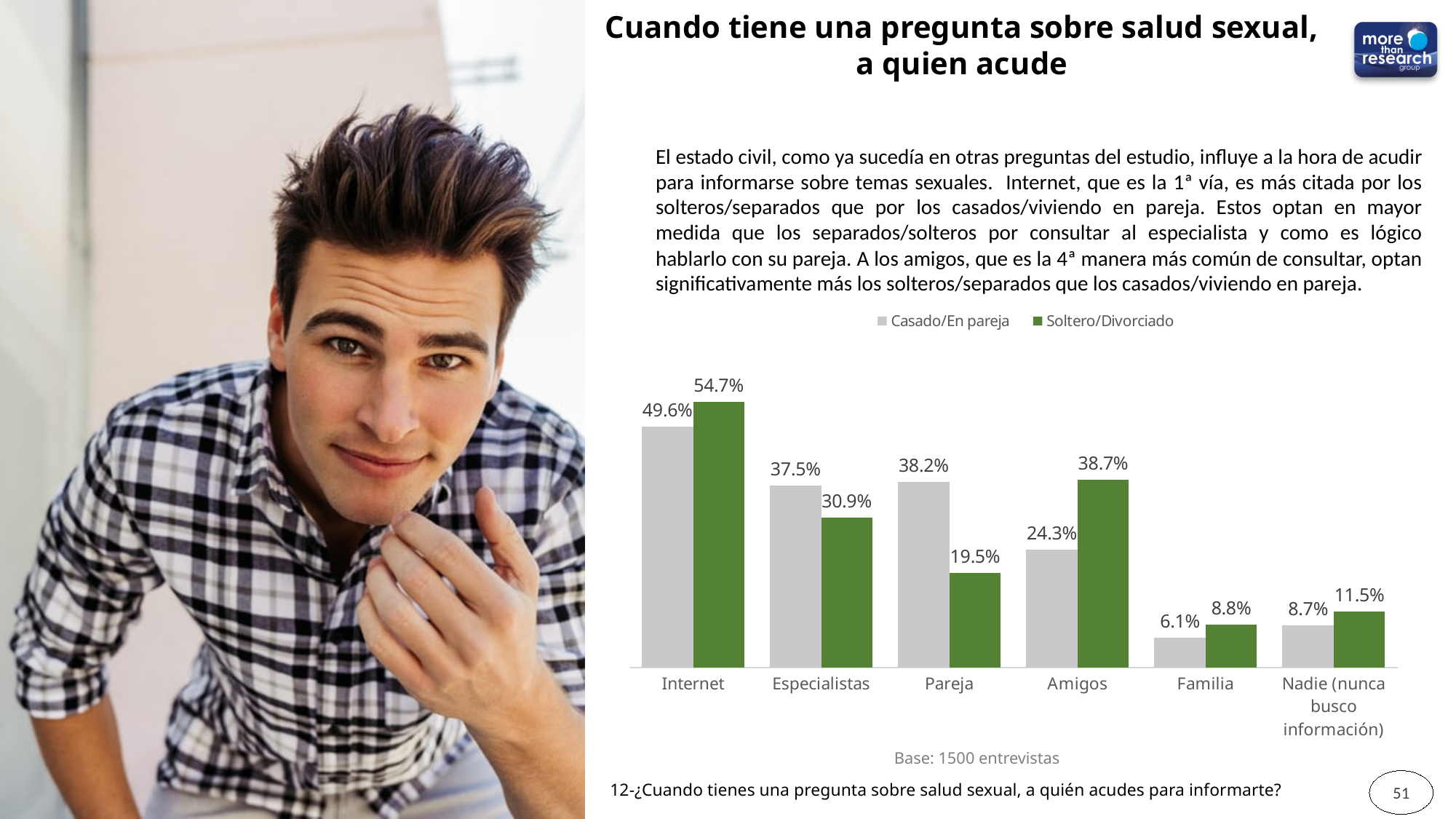
Which category has the lowest value in the Soltero/Divorciado series? Familia What kind of chart is shown on the slide? Bar chart What is the value for Internet in the Soltero/Divorciado series? 54.7% Which category has the highest value in the Casado/En pareja series? Internet How many series does the legend list? 2 Which is larger for Especialistas: Casado/En pareja or Soltero/Divorciado? Casado/En pareja What is the value for Pareja in the Casado/En pareja series? 38.2% Which is larger for Amigos: Casado/En pareja or Soltero/Divorciado? Soltero/Divorciado What is the difference between the Casado/En pareja and Soltero/Divorciado values for Pareja? 18.7% How many categories are shown on the x axis of the chart? 6 What is the value for Familia in the Soltero/Divorciado series? 8.8% What is the base (number of interviews) stated below the chart? 1500 entrevistas